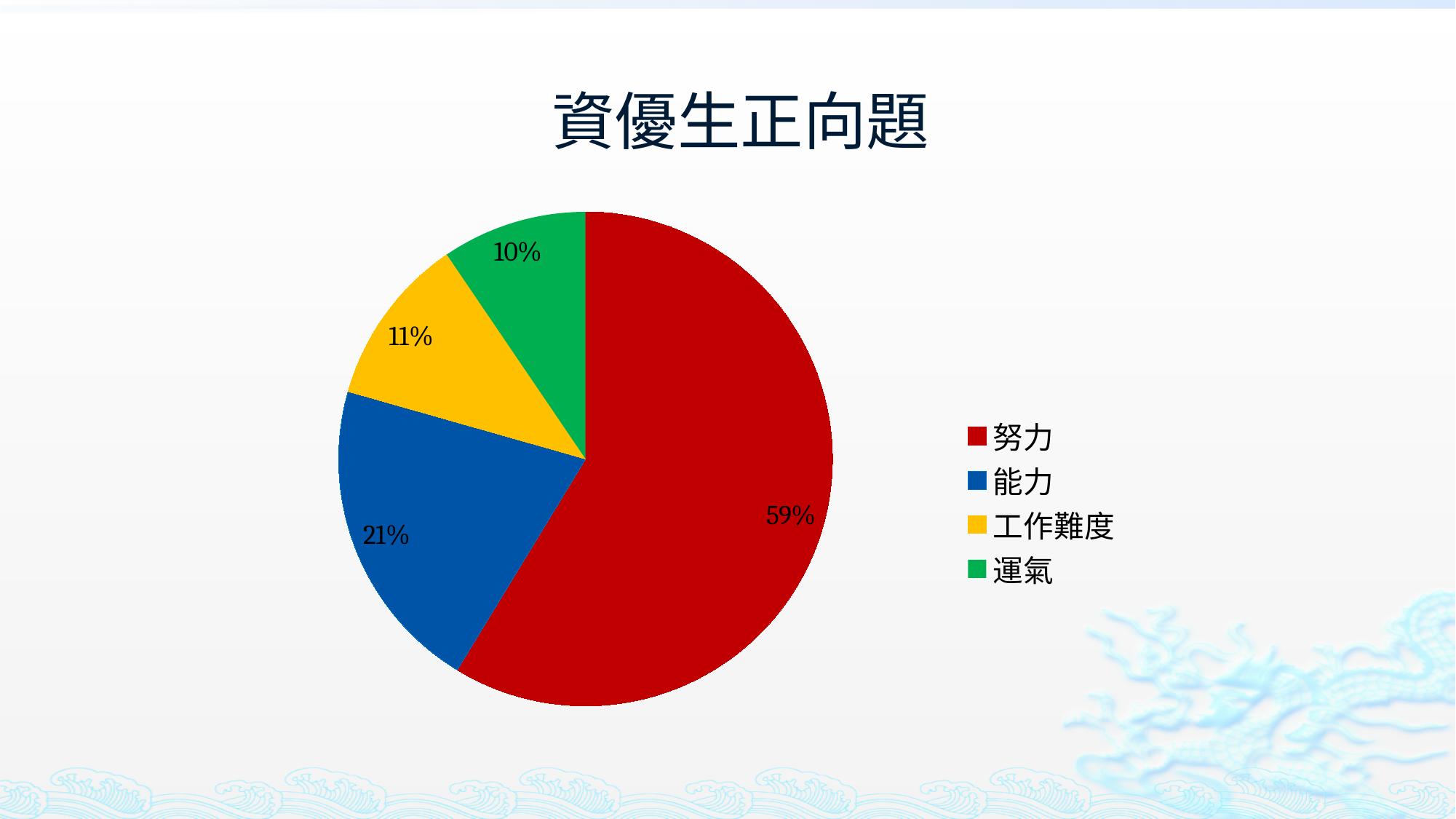
What percentage does the 能力 slice represent? 21% What type of chart is shown on the slide? pie chart Which category has the largest share of the pie? 努力 What is the title of the chart? 資優生正向題 What percentage does the 工作難度 slice represent? 11% What colour is the 工作難度 slice? yellow What is the difference in percentage points between 努力 and 能力? 38 Which category has the smallest share of the pie? 運氣 What percentage does the 運氣 slice represent? 10% What percentage does the 努力 slice represent? 59% Which is larger, the share for 能力 or the share for 工作難度? 能力 How many slices does the pie chart have? 4